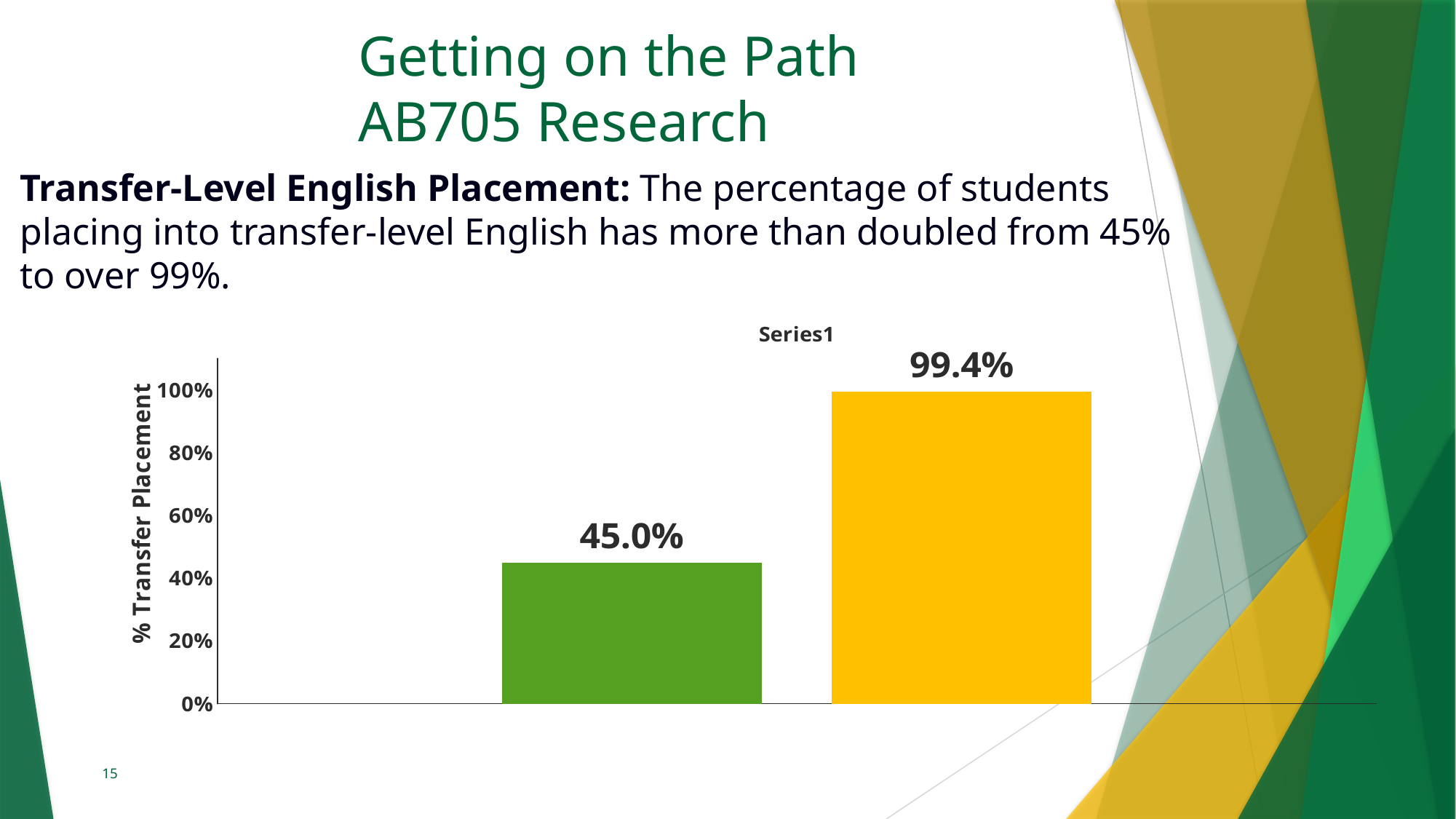
What is the difference between the yellow bar's value and the green bar's value? 54.4% What kind of chart is shown on the slide? bar chart Is the value of the right bar larger or smaller than the value of the left bar? larger Is the value of the green bar greater or less than 60%? less What is the label on the vertical axis of the chart? % Transfer Placement How many bars are plotted in the chart? 2 Which bar has the higher value, the green bar or the yellow bar? the yellow bar What is the value shown on the right (yellow) bar of the chart? 99.4% Which bar has the lower value, the green bar or the yellow bar? the green bar Is the value of the yellow bar greater or less than 80%? greater What is the value shown on the left (green) bar of the chart? 45.0% Do the values rise or fall from the left bar to the right bar? rise